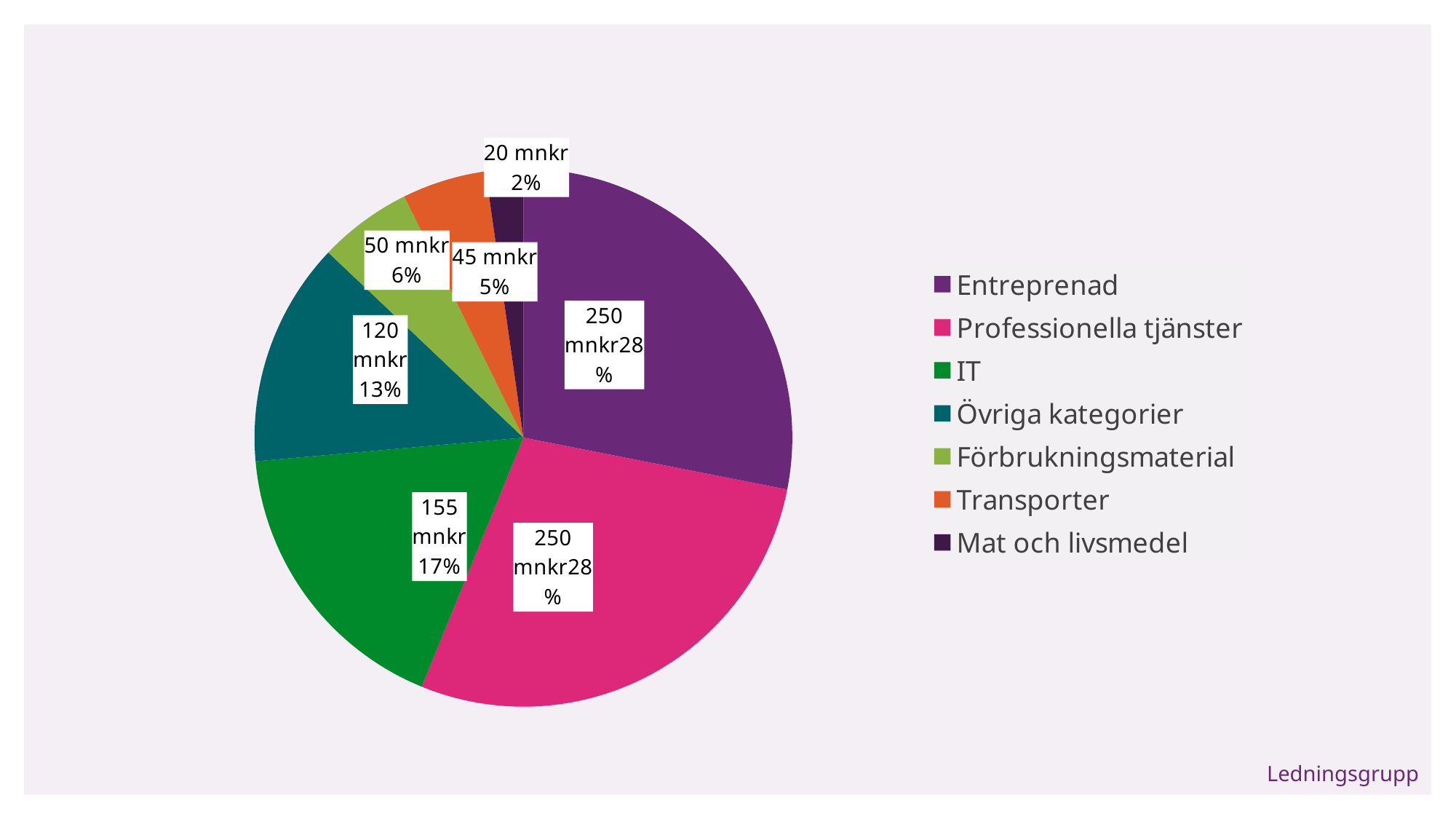
Which is larger, the value for Förbrukningsmaterial or the value for Transporter? Förbrukningsmaterial What is the value for IT? 155 mnkr What is the value for Övriga kategorier? 120 mnkr What share of the pie does Förbrukningsmaterial represent? 6% What is the difference between the values for IT and Övriga kategorier? 35 mnkr What is the value for Transporter? 45 mnkr Which category has the smallest slice? Mat och livsmedel Which colour represents Professionella tjänster in the legend? Pink What share of the pie does Entreprenad represent? 28% What is the difference between the values for Entreprenad and Mat och livsmedel? 230 mnkr What kind of chart is shown on the slide? Pie chart How many categories does the pie chart show? 7